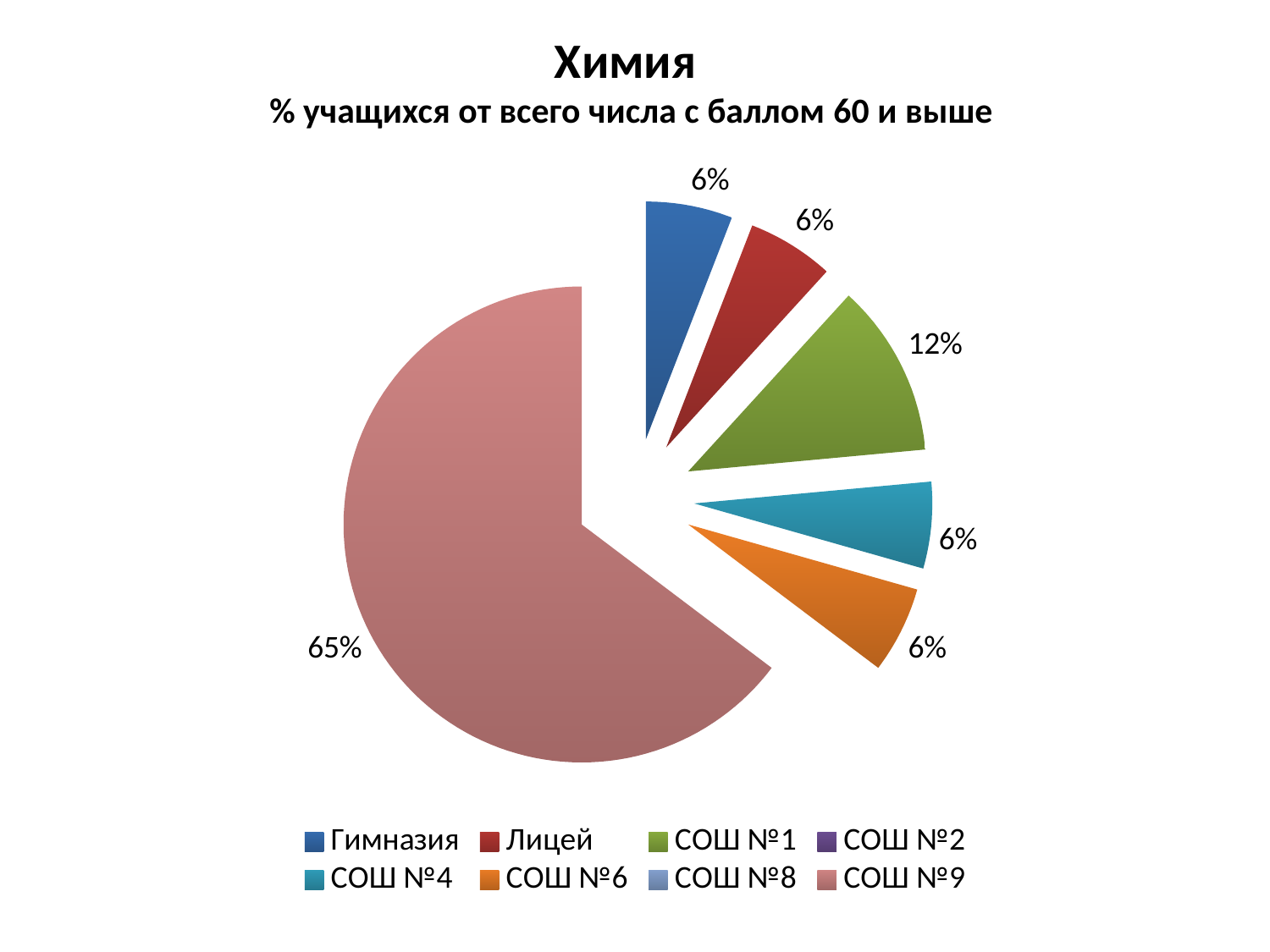
How many slices with data labels are visible in the pie? 6 What is the difference between the values for СОШ №9 and СОШ №1? 53% How many entries does the legend list? 8 What is the title of the chart? Химия Which category has the largest slice of the pie? СОШ №9 What is the value shown for Гимназия? 6% What is the difference between the values for СОШ №1 and Лицей? 6% What is the value shown for СОШ №6? 6% What is the value shown for СОШ №1? 12% Which is larger, the value for СОШ №1 or the value for СОШ №4? СОШ №1 What kind of chart is shown on the slide? pie chart What share of the pie does СОШ №9 have? 65%